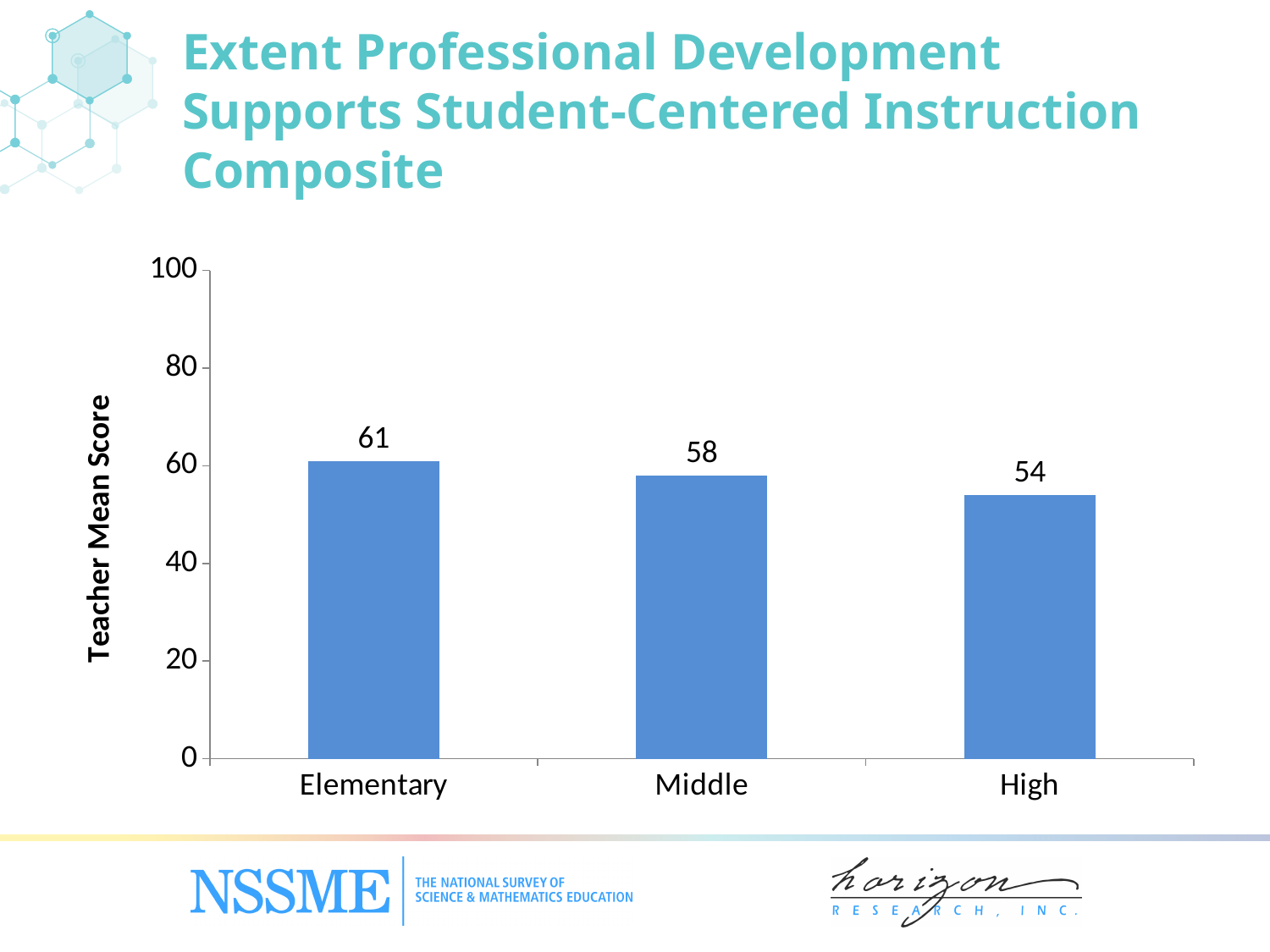
How many school levels are shown on the chart? 3 Do the teacher mean scores rise or fall from Elementary to High? Fall What is the teacher mean score for Middle? 58 Which school level has the lowest teacher mean score? High What kind of chart is shown on the slide? Bar chart Is the value for High greater or less than 60? less What is the teacher mean score for High? 54 What is the difference between the Elementary and High teacher mean scores? 7 Which has a higher teacher mean score, Elementary or Middle? Elementary What is the teacher mean score for Elementary? 61 What is the difference between the Middle and High teacher mean scores? 4 Which school level has the highest teacher mean score? Elementary